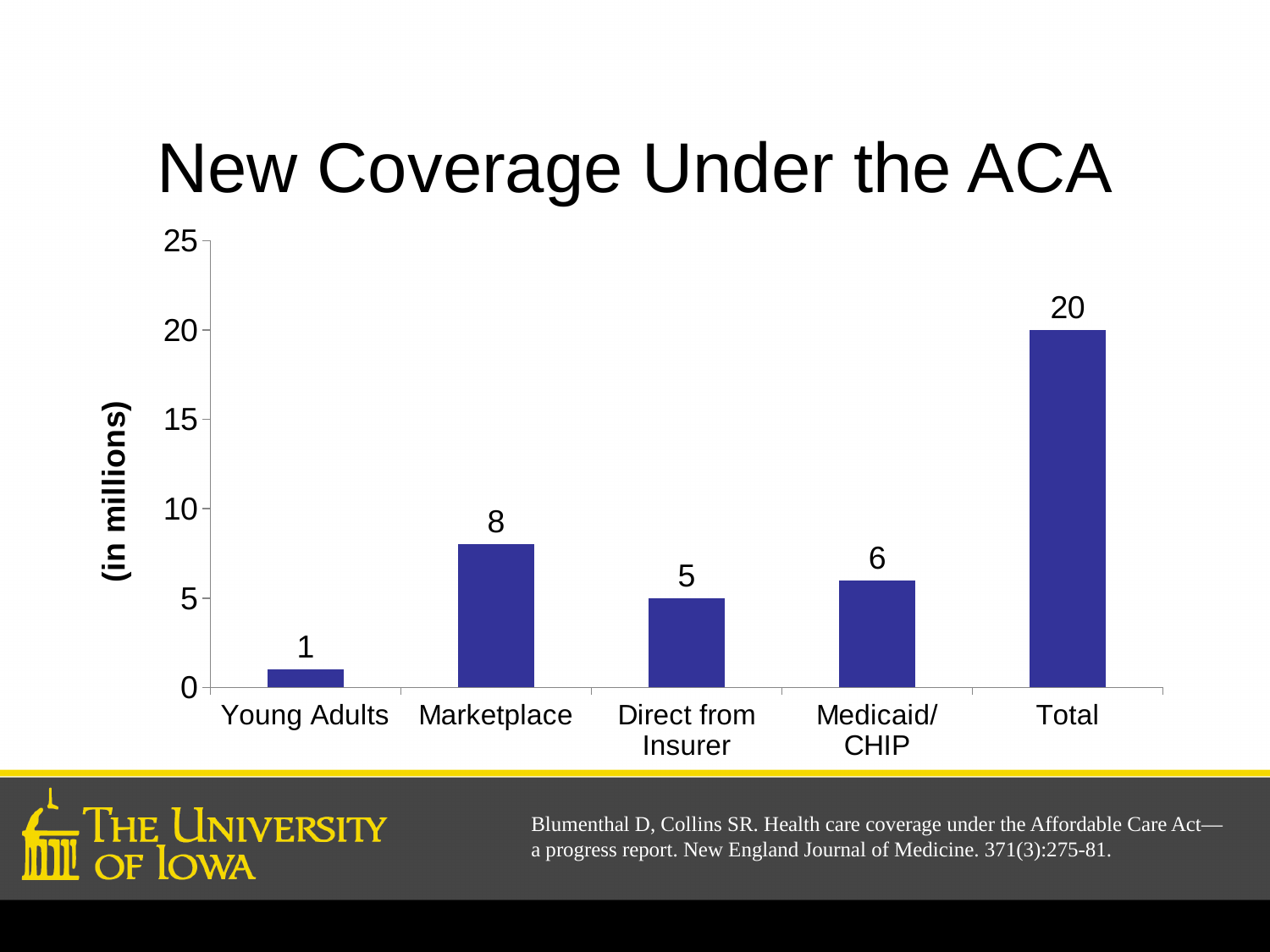
Is the value for Total greater or less than 15? greater Which category has the highest value? Total What is the value for Young Adults? 1 What is the value for Medicaid/CHIP? 6 What kind of chart is shown on the slide? bar chart What is the value for Marketplace? 8 What is the title of the chart? New Coverage Under the ACA How many categories are shown on the x axis? 5 Which category has the lowest value? Young Adults What is the value for Direct from Insurer? 5 Which is larger, the value for Medicaid/CHIP or the value for Direct from Insurer? Medicaid/CHIP What is the difference between the values for Marketplace and Direct from Insurer? 3